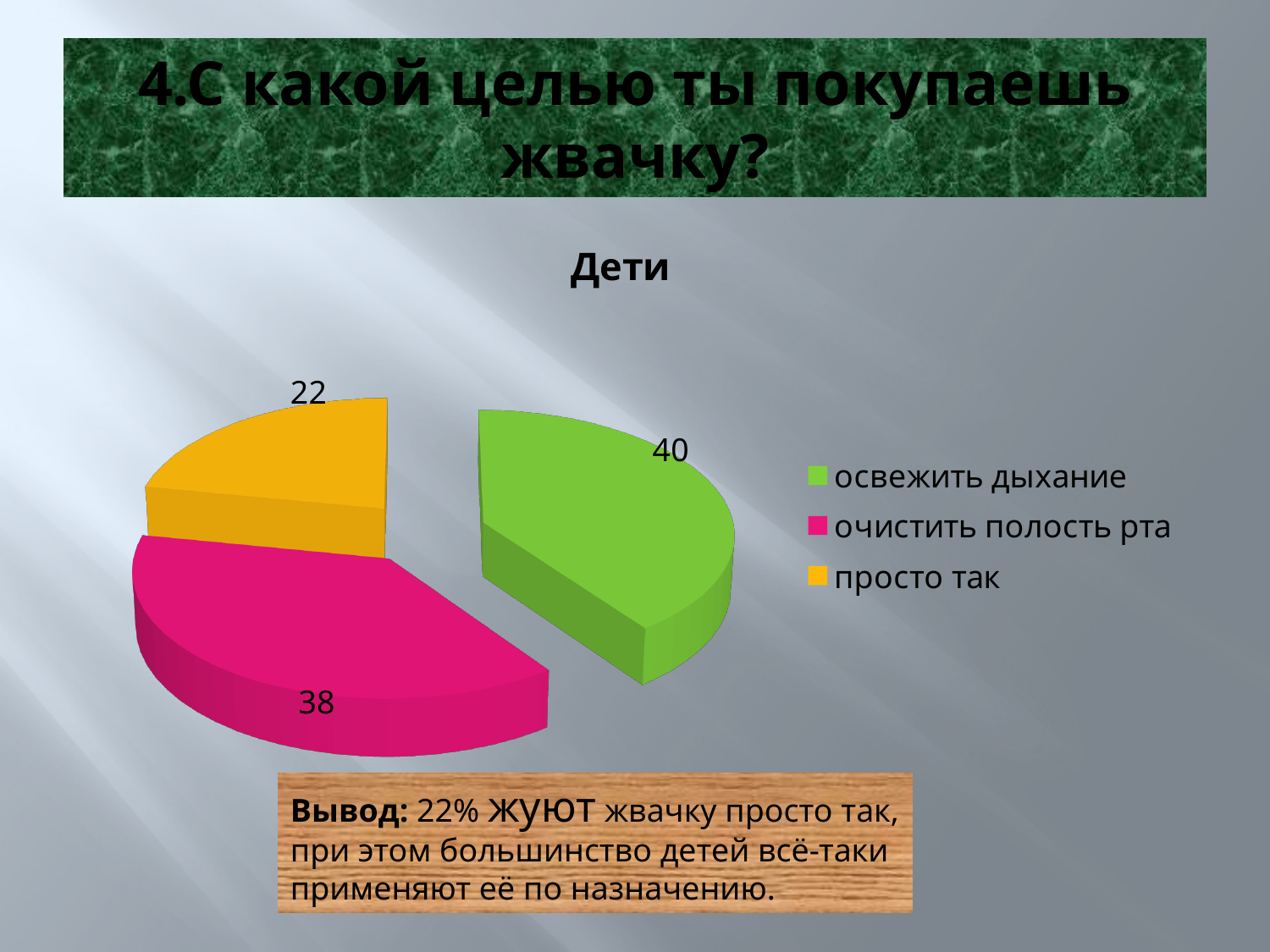
What is the value for просто так? 22 Which category has the smallest slice? просто так What is the value for освежить дыхание? 40 What is the difference between the values for очистить полость рта and просто так? 16 What share of the pie does просто так represent? 22% What is the difference between the values for освежить дыхание and очистить полость рта? 2 What kind of chart is shown on the slide? pie chart How many slices does the pie chart have? 3 Which category has the largest slice? освежить дыхание Which is larger, the value for очистить полость рта or the value for просто так? очистить полость рта What is the title of the chart? Дети What is the value for очистить полость рта? 38